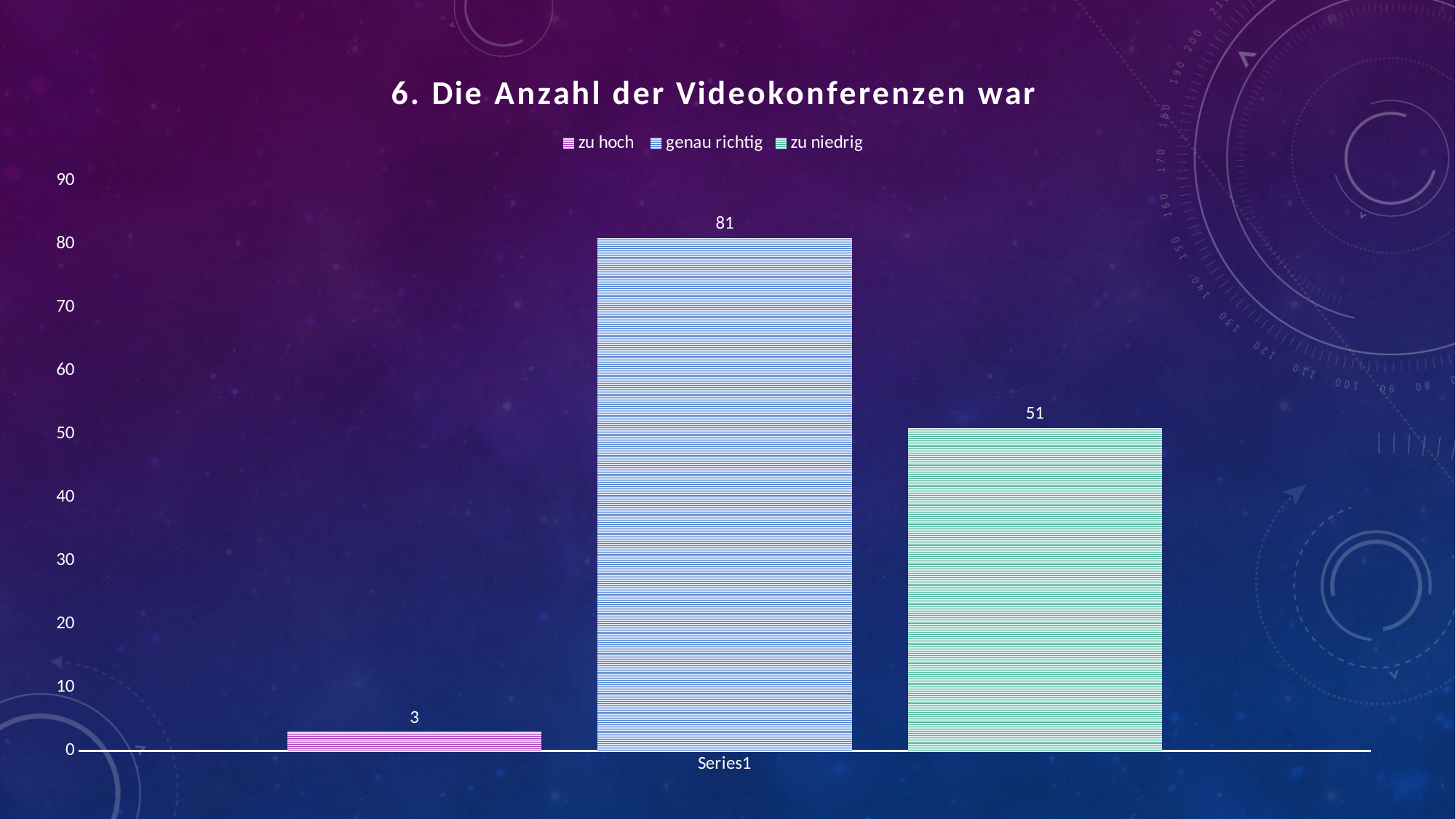
What is the difference between the values for "zu niedrig" and "zu hoch"? 48 What is the value for "zu hoch"? 3 Which series has the lowest value? zu hoch Which is larger, the value for "zu niedrig" or the value for "zu hoch"? zu niedrig How many series does the legend list? 3 What is the title of the chart? 6. Die Anzahl der Videokonferenzen war Which series has the highest value? genau richtig What is the difference between the values for "genau richtig" and "zu niedrig"? 30 What is the value for "zu niedrig"? 51 Is the value for "genau richtig" greater or less than 70? greater What kind of chart is shown on the slide? bar chart What is the value for "genau richtig"? 81